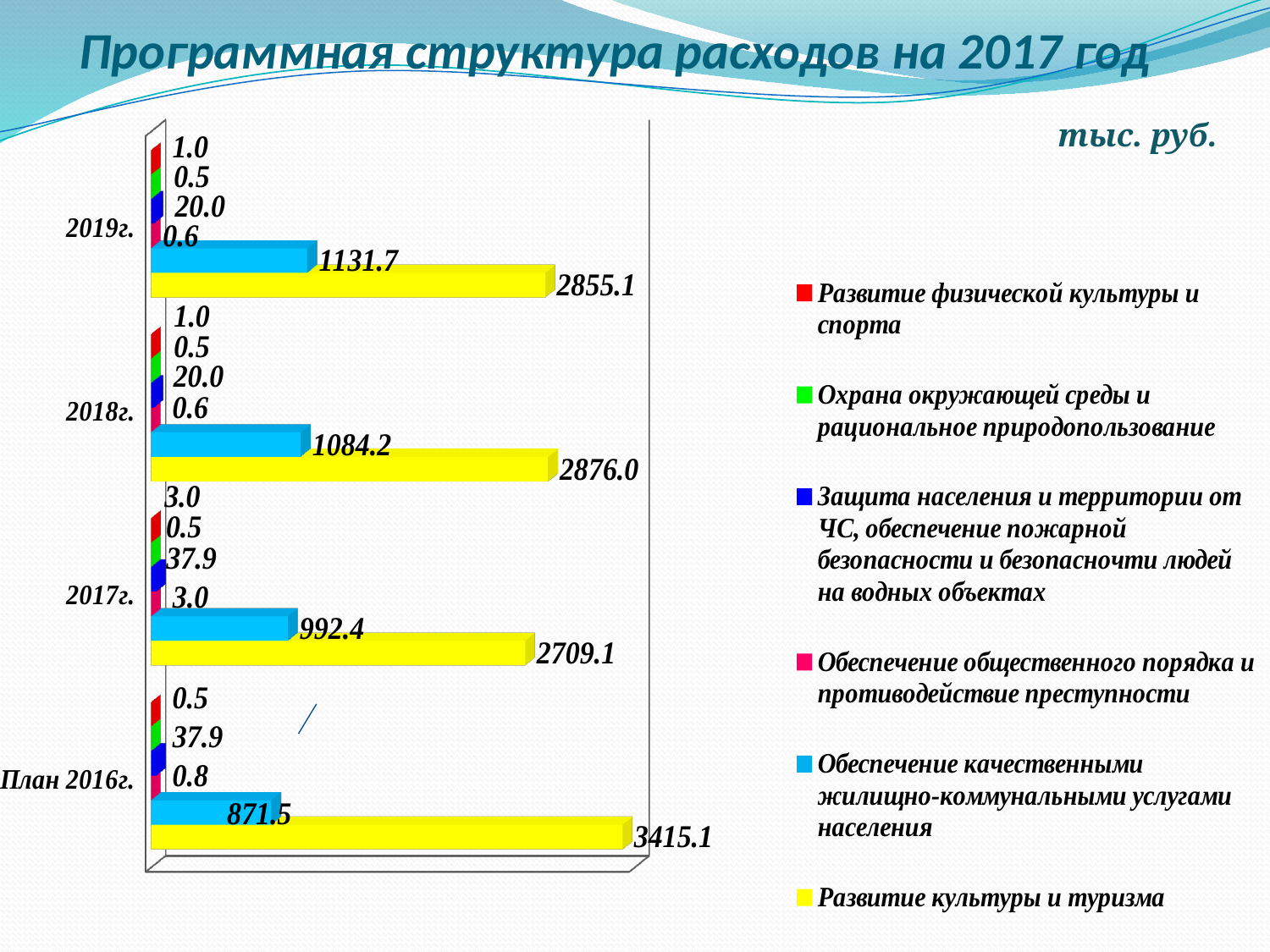
What is the value for Обеспечение качественными жилищно-коммунальными услугами населения in План 2016г.? 871.5 Which is larger, the Обеспечение качественными жилищно-коммунальными услугами населения value for 2019г. or for 2018г.? 2019г. What colour represents Развитие культуры и туризма in the chart? Yellow What is the value for Развитие культуры и туризма in 2019г.? 2855.1 Which category has the highest value for Развитие культуры и туризма? План 2016г. What is the difference between the Обеспечение качественными жилищно-коммунальными услугами населения values for 2019г. and 2018г.? 47.5 How many series does the legend list? 6 What is the value for Обеспечение качественными жилищно-коммунальными услугами населения in 2017г.? 992.4 What kind of chart is shown on the slide? Bar chart Which category has the lowest value for Развитие культуры и туризма? 2017г. How many year categories are shown on the chart? 4 What is the difference between the Развитие культуры и туризма values for 2018г. and 2019г.? 20.9